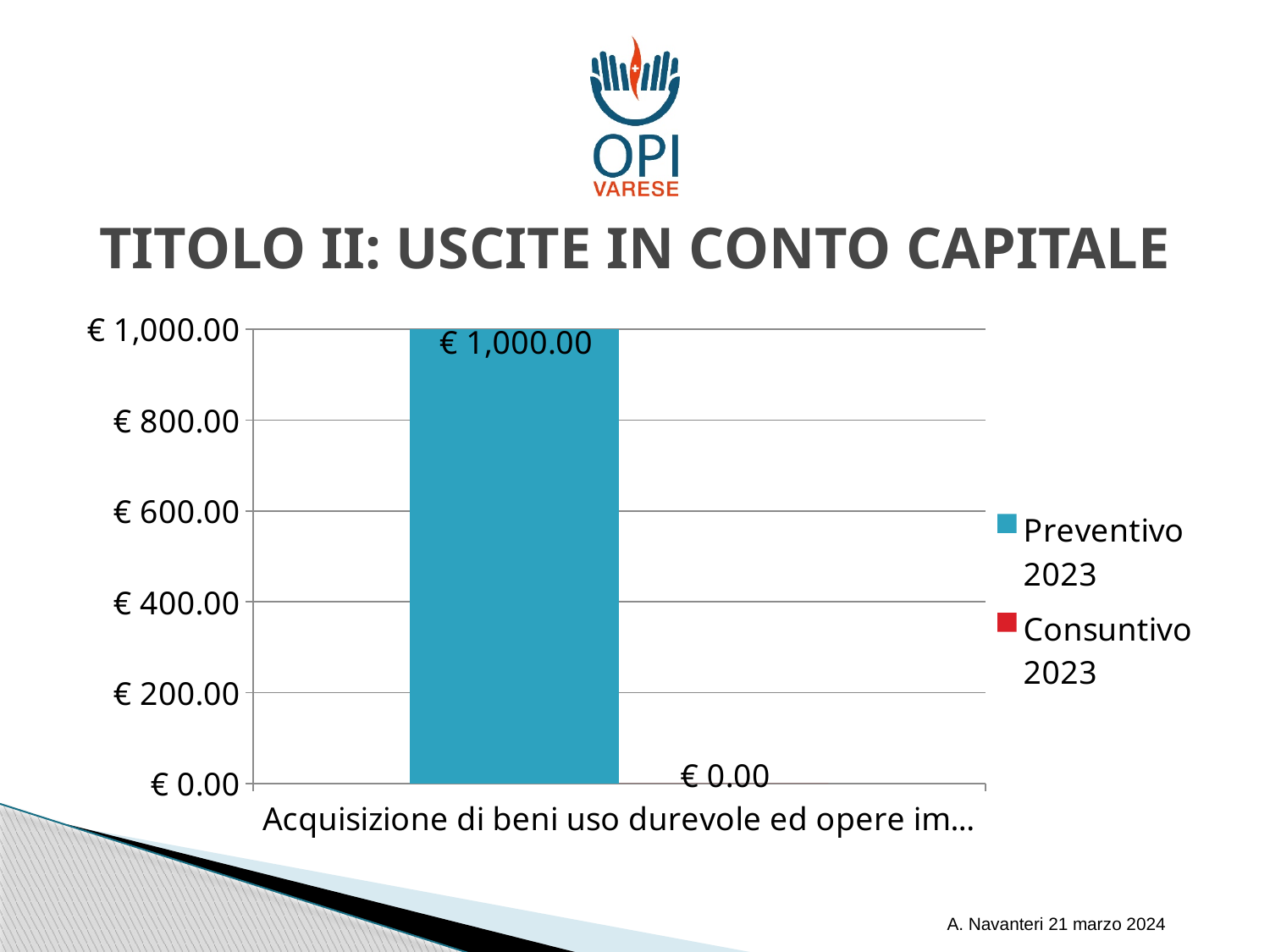
Is the value for Consuntivo 2023 greater or less than € 200.00? less How many categories are shown on the x axis? 1 What is the value of Preventivo 2023 for the category "Acquisizione di beni uso durevole ed opere im…"? € 1,000.00 What is the highest value shown on the y axis? € 1,000.00 What colour is the Preventivo 2023 series in the legend? Blue How many series does the legend list? 2 What is the value of Consuntivo 2023 for the category "Acquisizione di beni uso durevole ed opere im…"? € 0.00 What kind of chart is shown on the slide? Bar chart What is the difference between the Preventivo 2023 and Consuntivo 2023 values? € 1,000.00 Which series has the higher value: Preventivo 2023 or Consuntivo 2023? Preventivo 2023 Is the value for Preventivo 2023 greater or less than € 800.00? greater What is the title of the slide above the chart? TITOLO II: USCITE IN CONTO CAPITALE